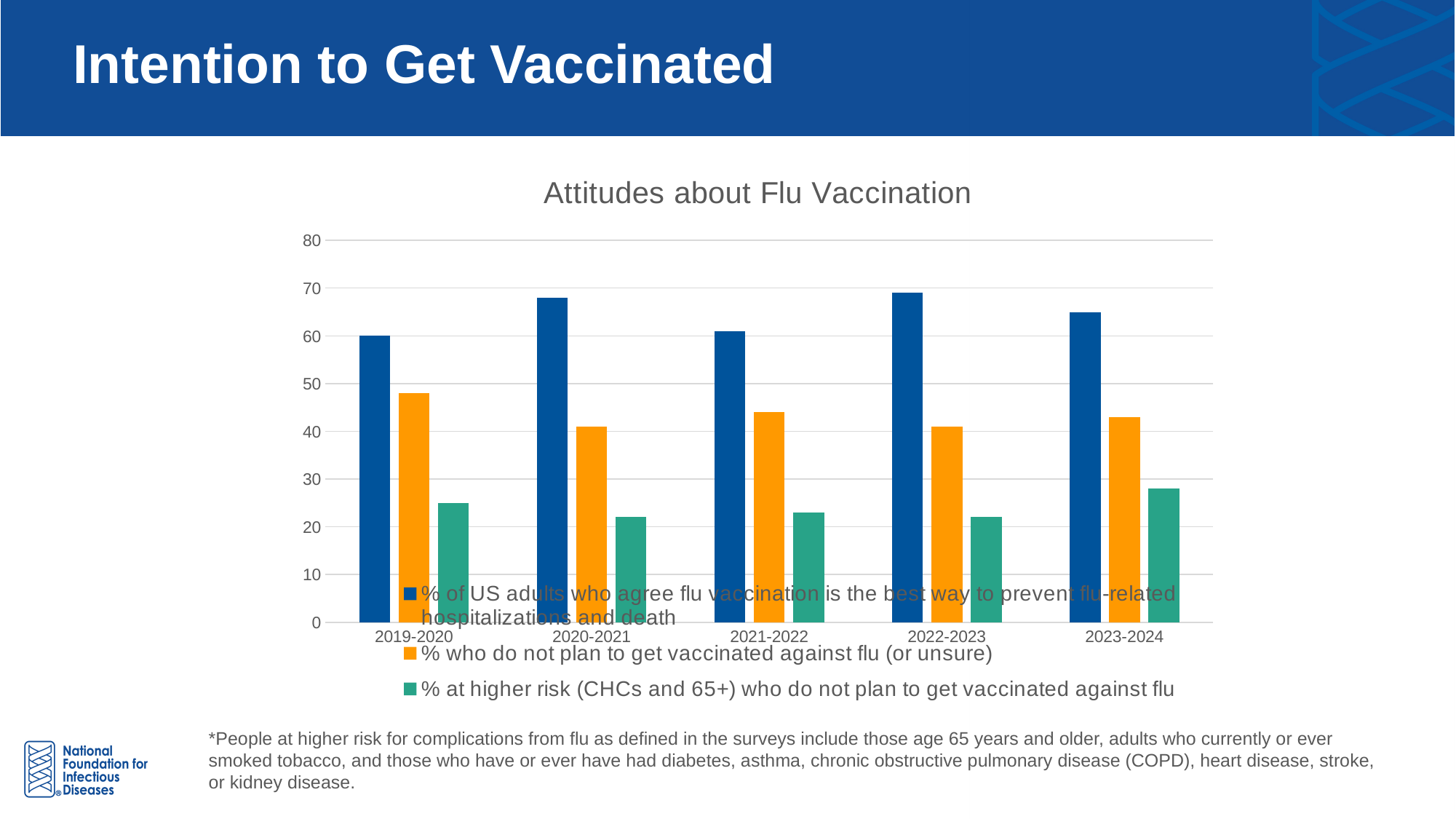
How many series does the chart's legend list? 3 For 2022-2023, which is larger: the % of US adults who agree flu vaccination is the best way to prevent flu-related hospitalizations and death, or the % who do not plan to get vaccinated against flu (or unsure)? % of US adults who agree flu vaccination is the best way to prevent flu-related hospitalizations and death What type of chart is shown on the slide? bar chart In which flu season is the % who do not plan to get vaccinated against flu (or unsure) highest? 2019-2020 Which colour represents the % who do not plan to get vaccinated against flu (or unsure) in the chart? orange Is the value for 2021-2022 for the % who do not plan to get vaccinated against flu (or unsure) greater or less than 40? greater Is the value for 2020-2021 for the % of US adults who agree flu vaccination is the best way to prevent flu-related hospitalizations and death greater or less than 60? greater Is the value for 2019-2020 for the % at higher risk (CHCs and 65+) who do not plan to get vaccinated against flu greater or less than 20? greater What is the title of the chart? Attitudes about Flu Vaccination In which flu season is the % at higher risk (CHCs and 65+) who do not plan to get vaccinated against flu highest? 2023-2024 What is the value for 2019-2020 for the % of US adults who agree flu vaccination is the best way to prevent flu-related hospitalizations and death? 60 How many flu seasons are shown on the x axis of the chart? 5